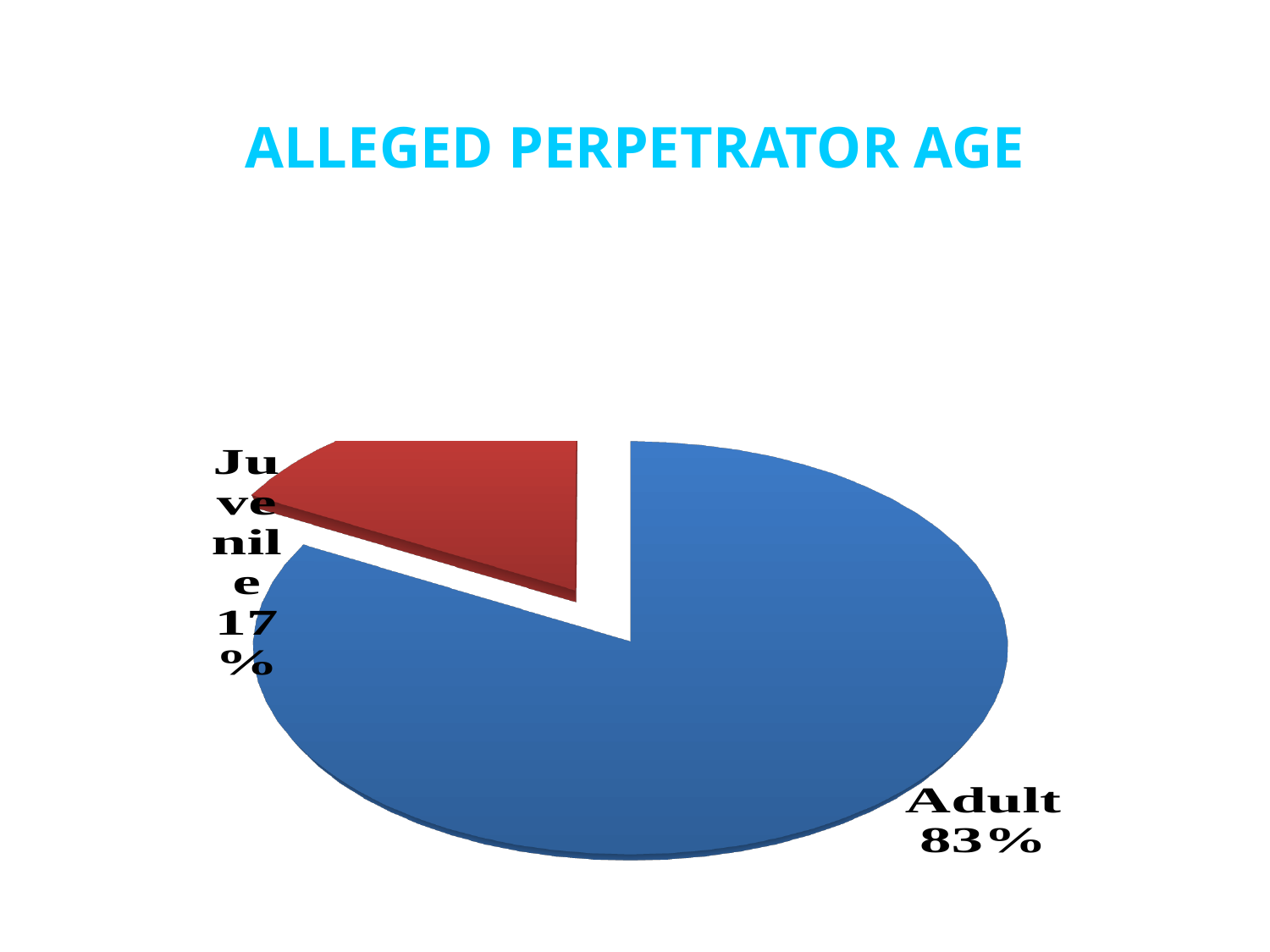
What type of chart is shown on the slide? pie chart Which category has the largest slice of the pie? Adult How many slices does the pie chart have? 2 What is the title of the chart? ALLEGED PERPETRATOR AGE What share of the pie does the Juvenile slice represent? 17% What is the total of the two slice percentages shown? 100% What colour is the Juvenile slice? red Which is larger, the Adult slice or the Juvenile slice? Adult Which category has the smallest slice of the pie? Juvenile What is the difference in percentage points between the Adult and Juvenile slices? 66 What share of the pie does the Adult slice represent? 83%